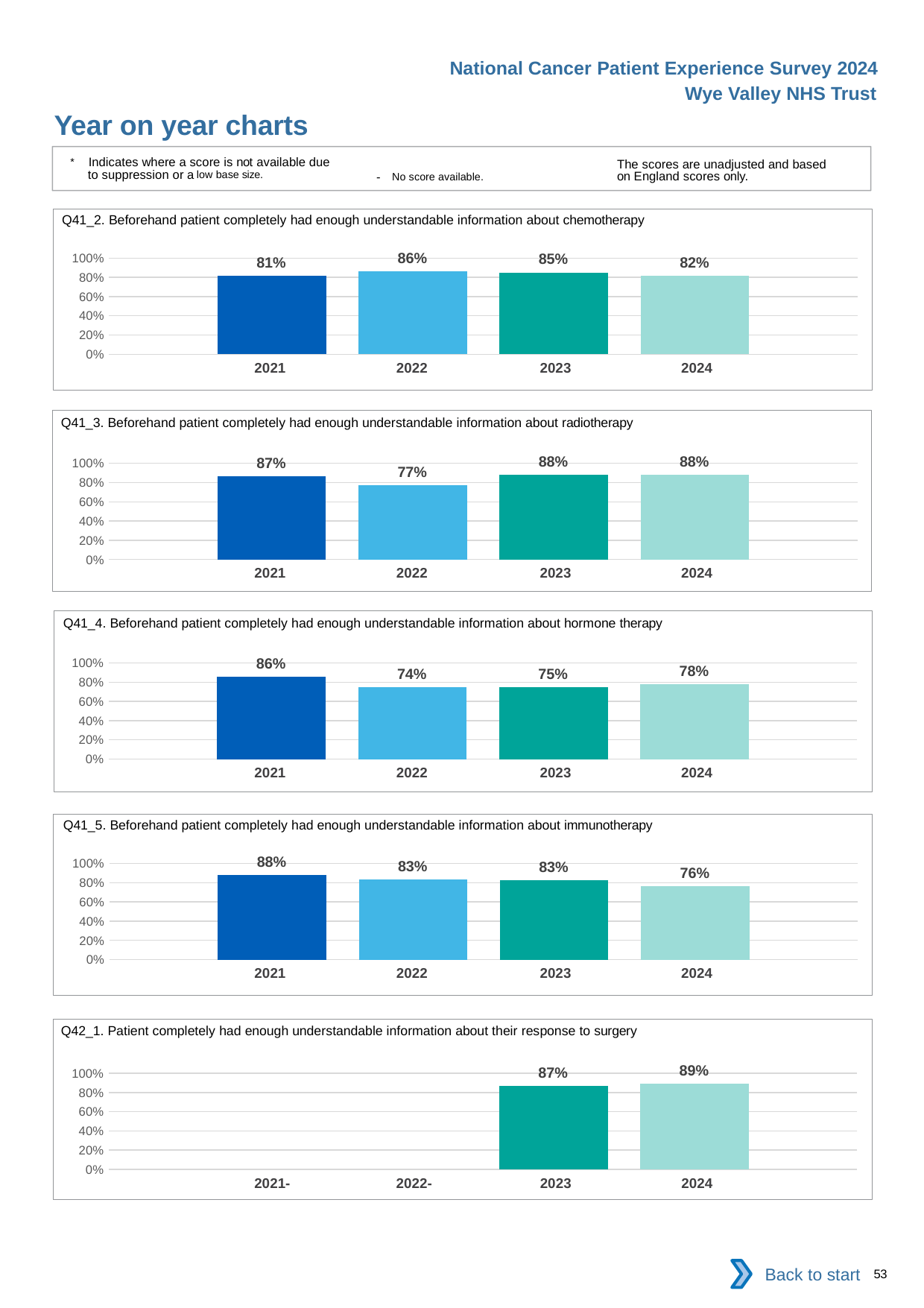
In the Q41_4 chart (hormone therapy), which year has the highest value? 2021 How many charts are shown on the slide? 5 In the Q41_3 chart (radiotherapy), what is the difference between the 2023 and 2022 values? 11% In the Q41_2 chart (chemotherapy), which year has the lowest value? 2021 In the Q41_2 chart (chemotherapy), what is the value for 2022? 86% In the Q41_3 chart (radiotherapy), what is the value for 2022? 77% In the Q41_5 chart (immunotherapy), do the values rise or fall from 2021 to 2024? fall In the Q42_1 chart (response to surgery), how many years have a bar plotted? 2 In the Q41_4 chart (hormone therapy), what is the value for 2024? 78% What kind of chart is the Q41_2 chart (chemotherapy)? bar chart In the Q42_1 chart (response to surgery), what is the value for 2024? 89% In the Q41_5 chart (immunotherapy), which is larger, the value for 2021 or the value for 2024? 2021